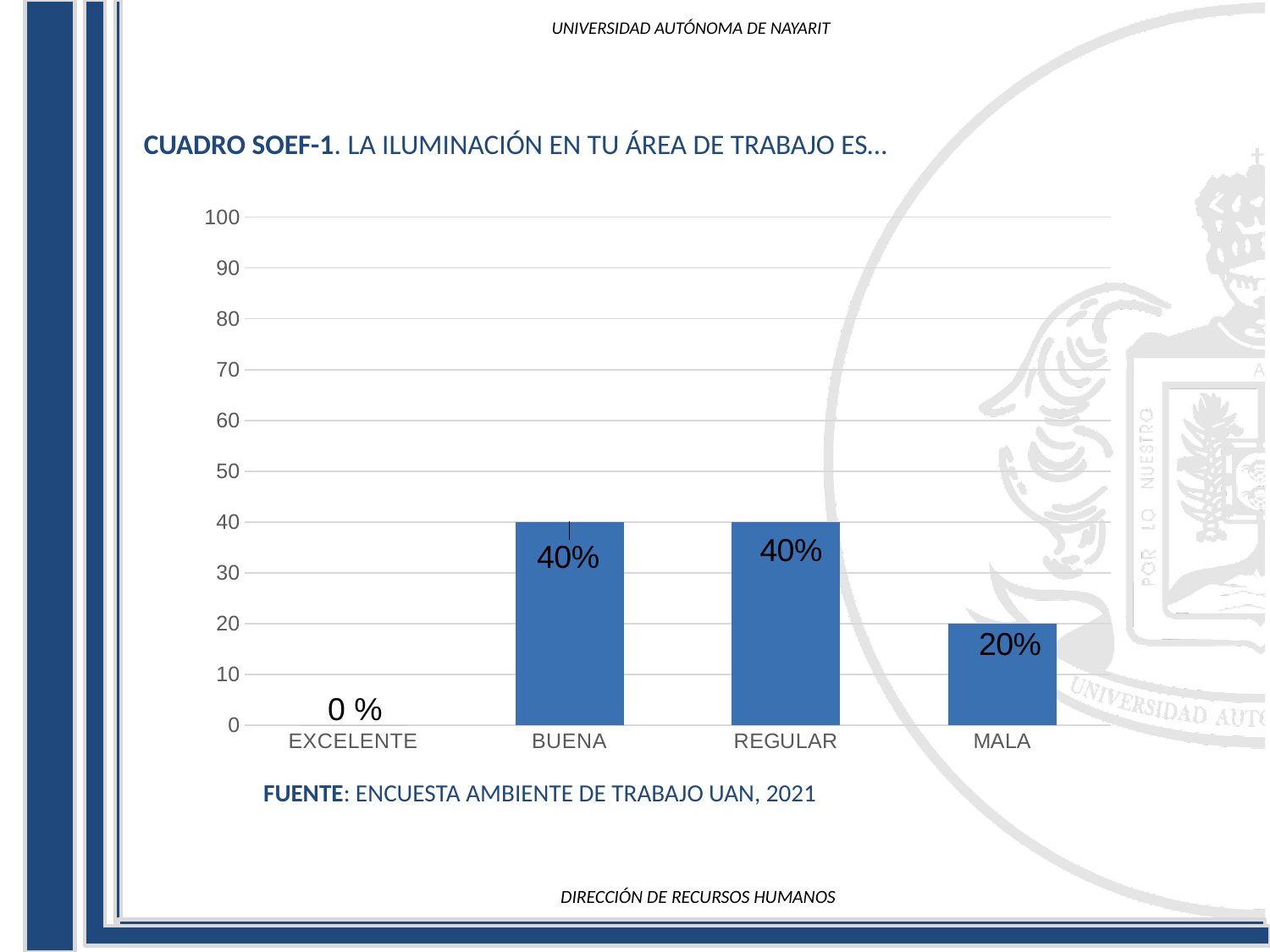
Which category has the lowest value? EXCELENTE How many categories are shown on the x axis? 4 What kind of chart is shown on the slide? bar chart What is the source cited below the chart? ENCUESTA AMBIENTE DE TRABAJO UAN, 2021 Is the value for MALA greater or less than 30? less What is the difference between the values for REGULAR and MALA? 20% What is the value for REGULAR? 40% What is the value for EXCELENTE? 0 % What is the value for BUENA? 40% What is the highest value shown on the y axis? 100 Which is larger, the value for BUENA or the value for MALA? BUENA What is the value for MALA? 20%